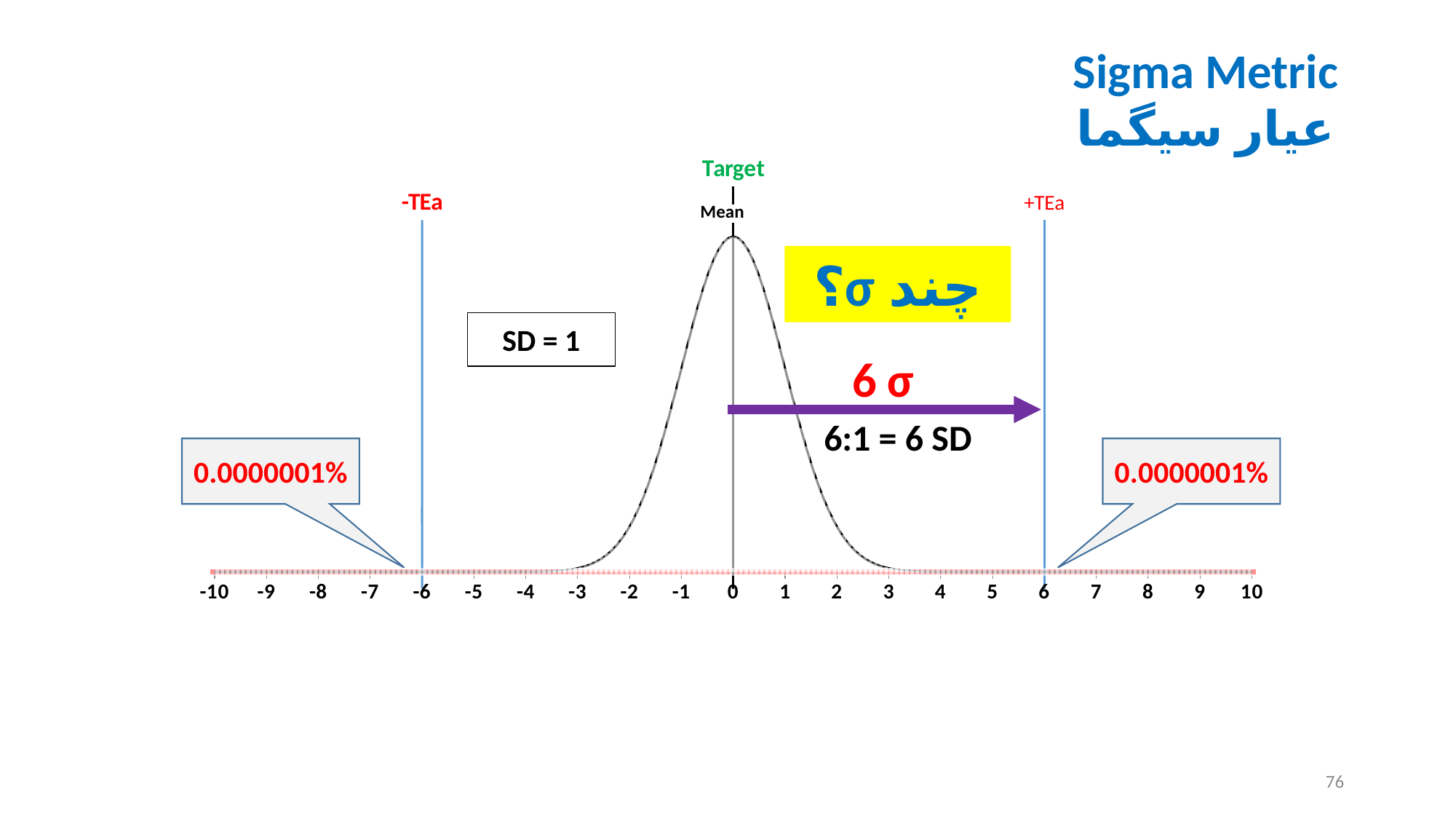
At which x-axis value is the Mean (Target) line drawn? 0 What is the English title shown at the top right of the slide? Sigma Metric At which x-axis value does the curve reach its highest point? 0 At which x-axis value is the +TEa line drawn? 6 At which x-axis value is the -TEa line drawn? -6 How many SD units separate the Mean line from the +TEa line, according to the label under the arrow? 6 SD Does the curve rise or fall as x increases from 0 to 6? fall What SD value is stated in the box on the chart? SD = 1 How many tick labels are shown on the x axis? 21 What percentage is shown in the callout at the right tail beyond +TEa? 0.0000001% What kind of chart is shown on the slide? line chart What percentage is shown in the callout at the left tail beyond -TEa? 0.0000001%